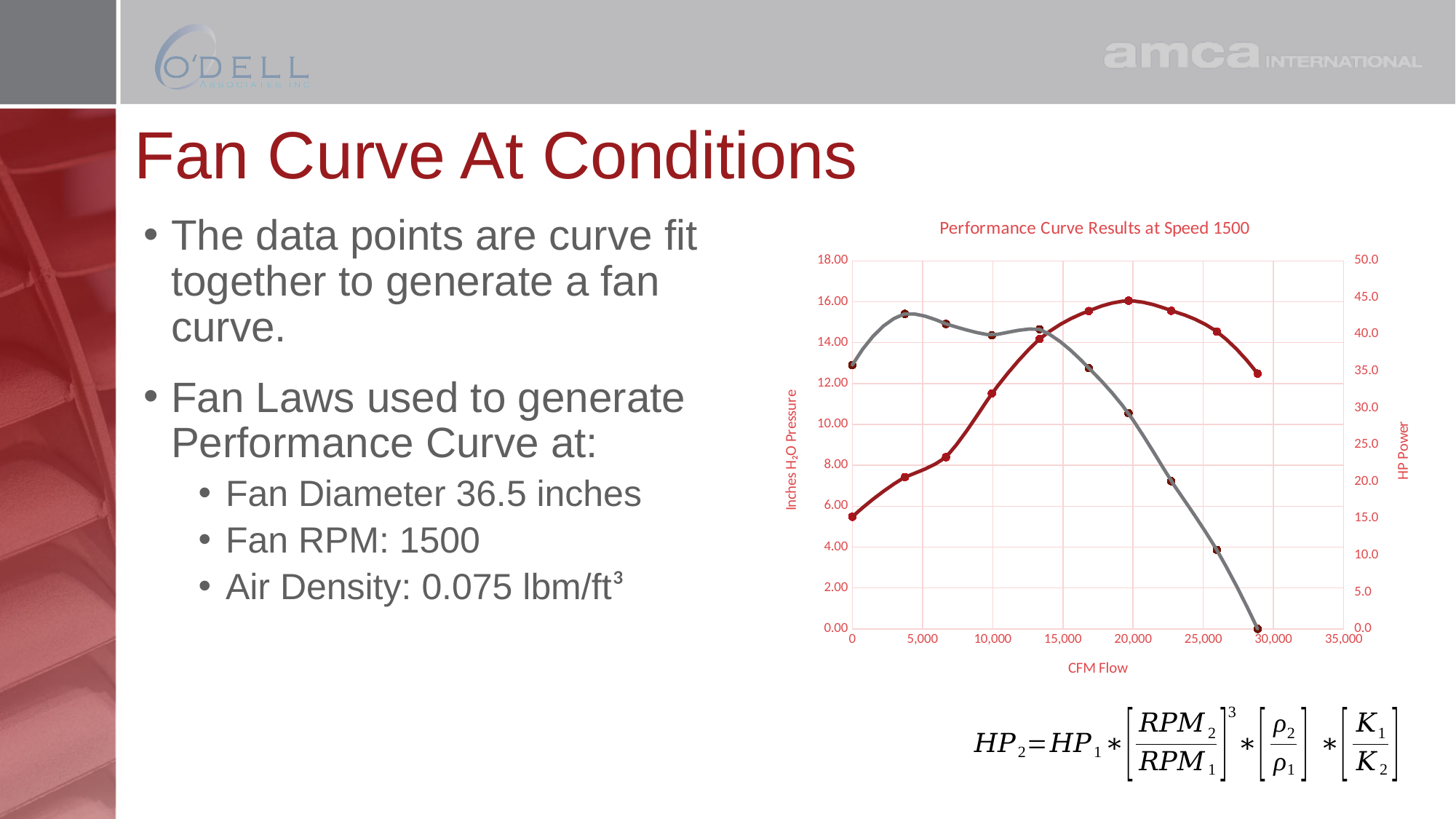
What kind of chart is shown on the slide? line chart What is the label of the right-hand vertical axis of the chart? HP Power What is the title of the chart? Performance Curve Results at Speed 1500 Is the peak HP Power value on the chart greater or less than 40.0? greater How many data series are plotted on the chart? 2 Is the Inches H2O Pressure value at the last plotted point (around 29,000 CFM) greater or less than 2.00? less Is the HP Power value at 0 CFM Flow greater or less than 20.0? less Does the Inches H2O Pressure curve rise or fall between 15,000 and 30,000 CFM Flow? fall Does the HP Power curve rise or fall between 0 and 15,000 CFM Flow? rise How many data points are plotted on the Inches H2O Pressure (gray) curve? 10